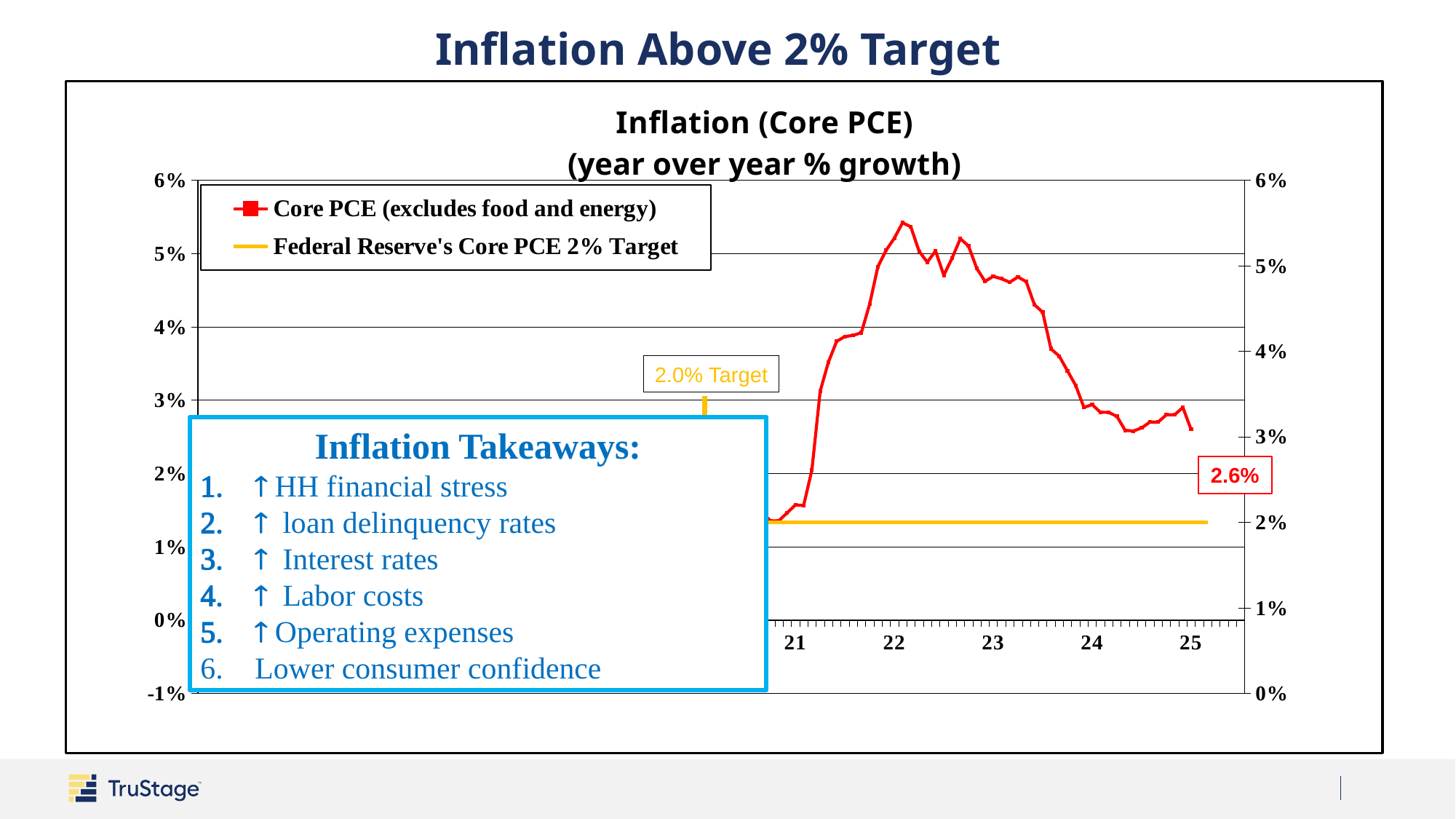
What colour is the Core PCE (excludes food and energy) line? red What is the most recent Core PCE value labeled on the chart? 2.6% How many series does the legend of the Inflation (Core PCE) chart list? 2 Does the Core PCE line rise or fall from its peak near 22 to 25? fall Is the peak Core PCE value on the chart greater or less than 5%? greater Near which year tick does the Core PCE line reach its highest point? 22 Which is larger, the latest Core PCE value or the Federal Reserve's 2% target? the latest Core PCE value (2.6%) What is the Federal Reserve's Core PCE target value shown on the chart? 2.0% What is the title of the chart? Inflation (Core PCE) (year over year % growth) By how much does the latest Core PCE value of 2.6% exceed the 2.0% target? 0.6% What type of chart is shown on the slide? line chart Is the Core PCE value at the 24 tick greater or less than 2%? greater